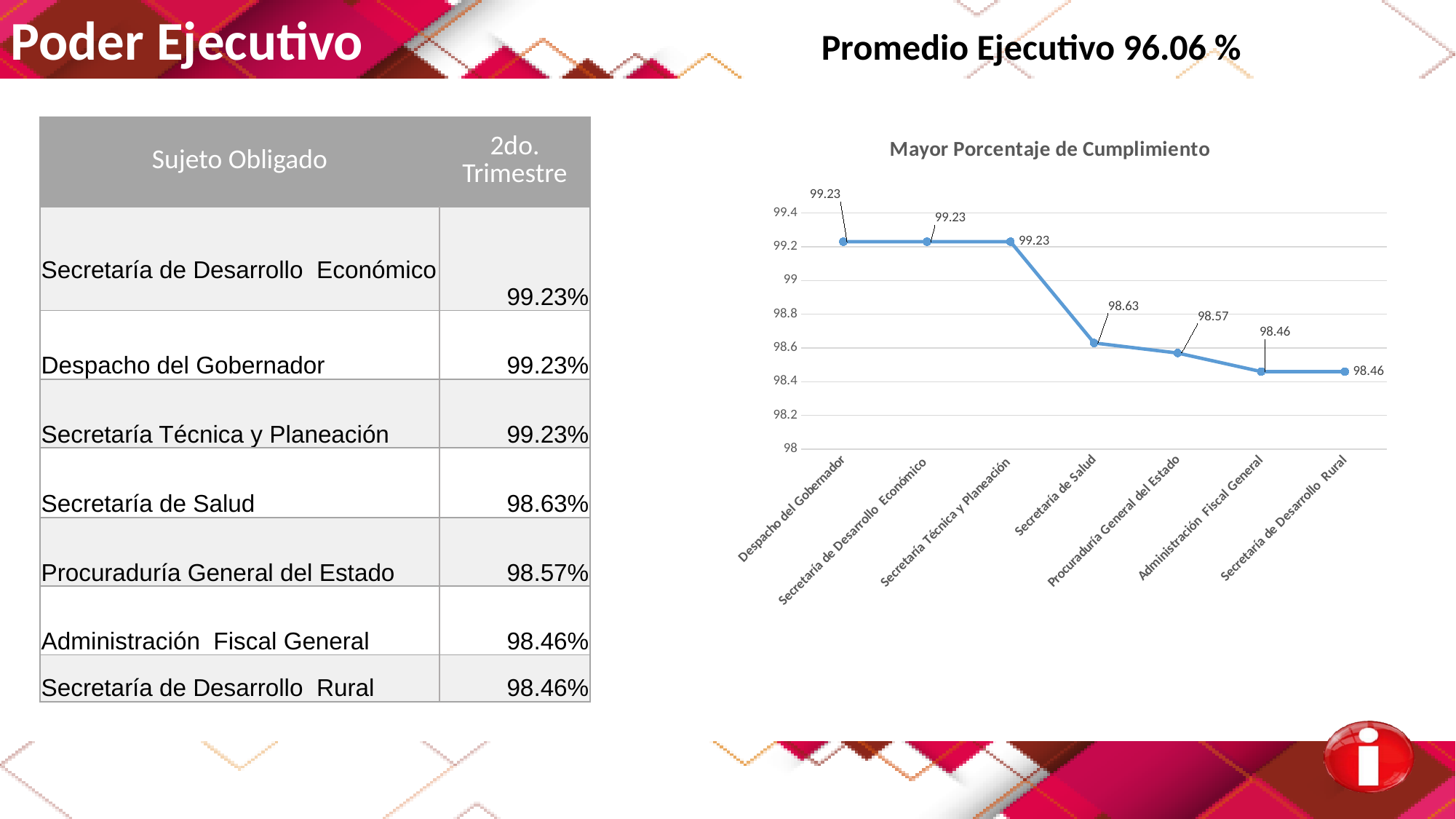
Which category has the lowest value on the chart, Secretaría de Salud or Secretaría de Desarrollo Rural? Secretaría de Desarrollo Rural What is the difference between the values for Secretaría Técnica y Planeación and Secretaría de Salud? 0.6 What is the title of the chart? Mayor Porcentaje de Cumplimiento Is the value for Secretaría de Salud greater or less than 99? less How many categories are plotted on the chart? 7 What type of chart is shown on the slide? line chart What is the value for Procuraduría General del Estado on the chart? 98.57 Do the values rise or fall from left to right along the x axis? fall What is the difference between the values for Secretaría de Salud and Procuraduría General del Estado? 0.06 What is the value for Administración Fiscal General on the chart? 98.46 What is the value for Despacho del Gobernador on the chart? 99.23 What is the value for Secretaría de Salud on the chart? 98.63